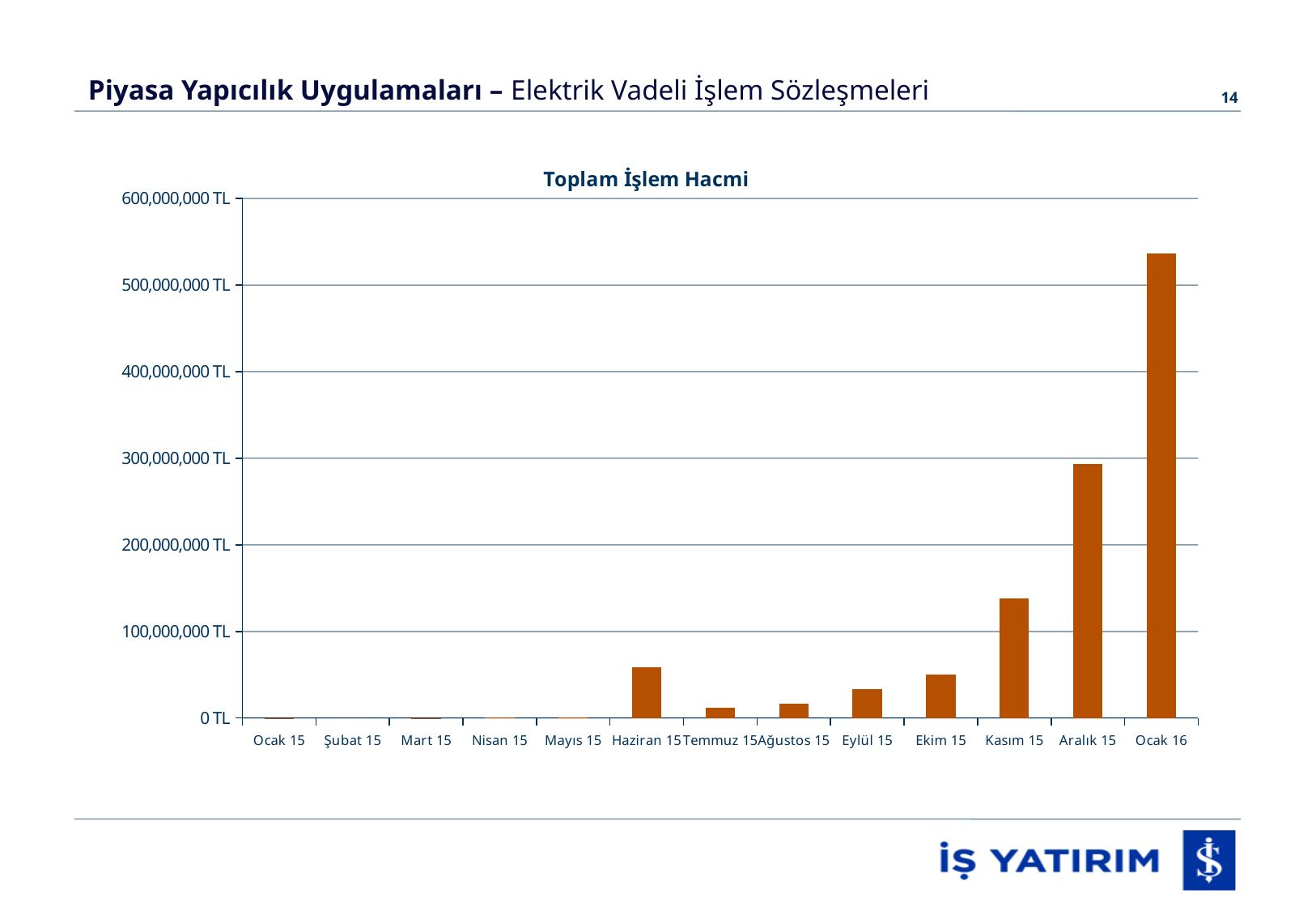
What kind of chart is shown on the slide? bar chart Which is larger, the value for Ocak 16 or the value for Aralık 15? Ocak 16 Which is larger, the value for Ekim 15 or the value for Eylül 15? Ekim 15 Which is larger, the value for Haziran 15 or the value for Temmuz 15? Haziran 15 Which month has the highest total transaction volume? Ocak 16 Is the value for Kasım 15 greater or less than 100,000,000 TL? greater Is the value for Ocak 16 greater or less than 500,000,000 TL? greater Is the value for Haziran 15 greater or less than 100,000,000 TL? less What is the title of the chart? Toplam İşlem Hacmi Do the values generally rise or fall from Haziran 15 to Ocak 16? rise How many months are shown on the x axis of the chart? 13